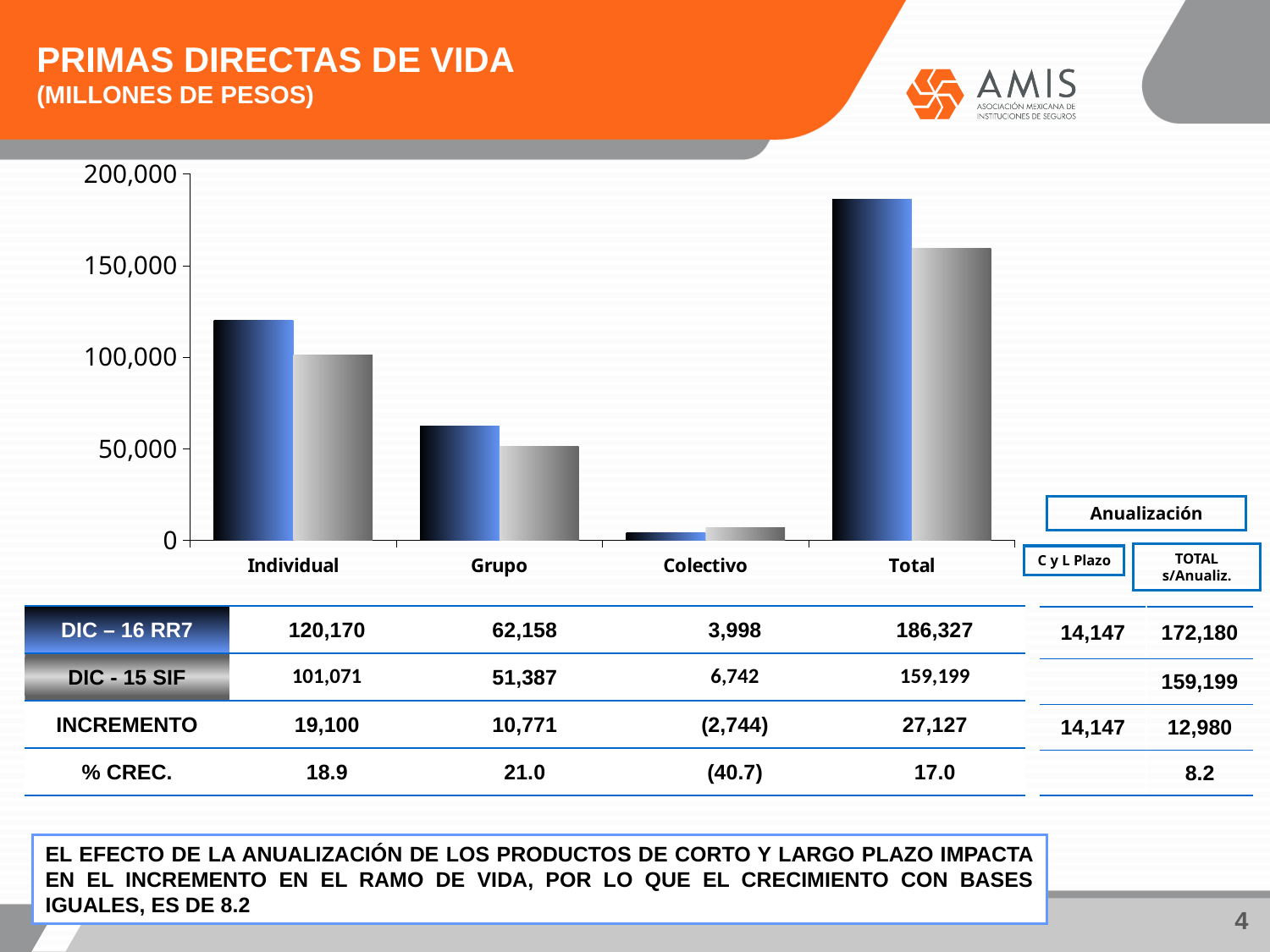
What type of chart is shown on the slide? bar chart Which category has the highest value in the DIC - 15 SIF series? Total Is the DIC – 16 RR7 value for Grupo greater or less than 50,000? greater What is the value for Colectivo in the DIC – 16 RR7 series? 3,998 What is the Total value for the DIC - 15 SIF series? 159,199 For Colectivo, which series has the larger value, DIC – 16 RR7 or DIC - 15 SIF? DIC - 15 SIF What is the value for Grupo in the DIC - 15 SIF series? 51,387 What is the value for Individual in the DIC – 16 RR7 series? 120,170 Which category has the lowest value in the DIC – 16 RR7 series? Colectivo What is the difference between the DIC – 16 RR7 and DIC - 15 SIF values for Individual? 19,100 How many data series does the chart show? 2 How many categories are shown on the x axis of the chart? 4